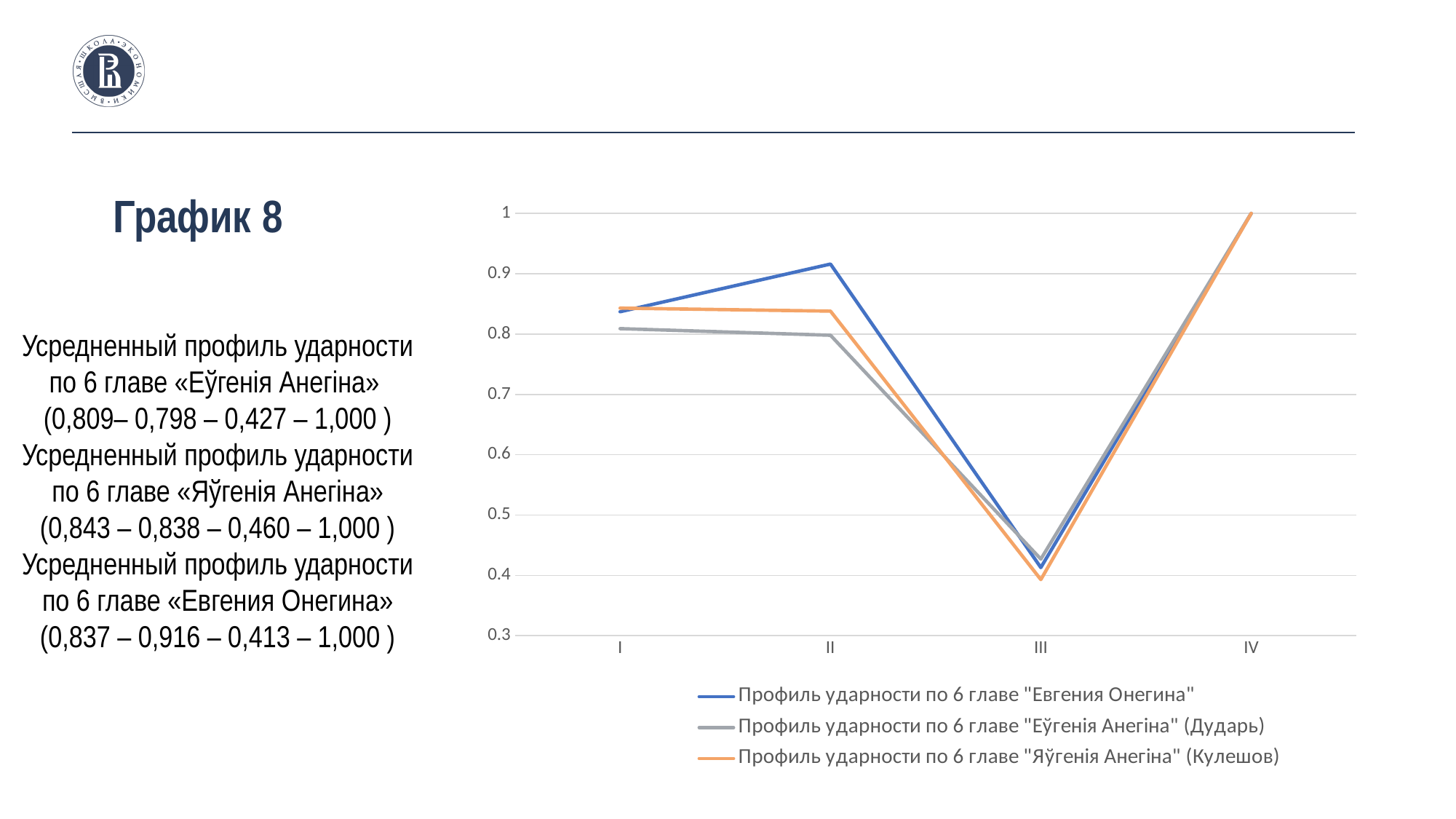
According to the text on the slide, what is the difference between the second values of the «Евгения Онегина» profile (0,916) and the «Еўгенія Анегіна» profile (0,798)? 0,118 Is the value for "Еўгенія Анегіна" (Дударь) at point III greater or less than 0.5? less Is the value for "Евгения Онегина" at point II greater or less than 0.9? greater At point II, which series has the larger value: "Евгения Онегина" or "Еўгенія Анегіна" (Дударь)? Евгения Онегина What colour is the line for "Профиль ударности по 6 главе "Евгения Онегина"" in the chart? blue How many points are there along the x axis of the chart? 4 What kind of chart is shown on the slide? line chart At which x-axis point does the series "Евгения Онегина" reach its highest value? IV According to the text on the slide, what is the value of the averaged profile for «Евгения Онегина» at the second point? 0,916 At which x-axis point does the series "Евгения Онегина" reach its lowest value? III How many series does the legend of the chart list? 3 Do the values of the series "Евгения Онегина" rise or fall from point II to point III? fall